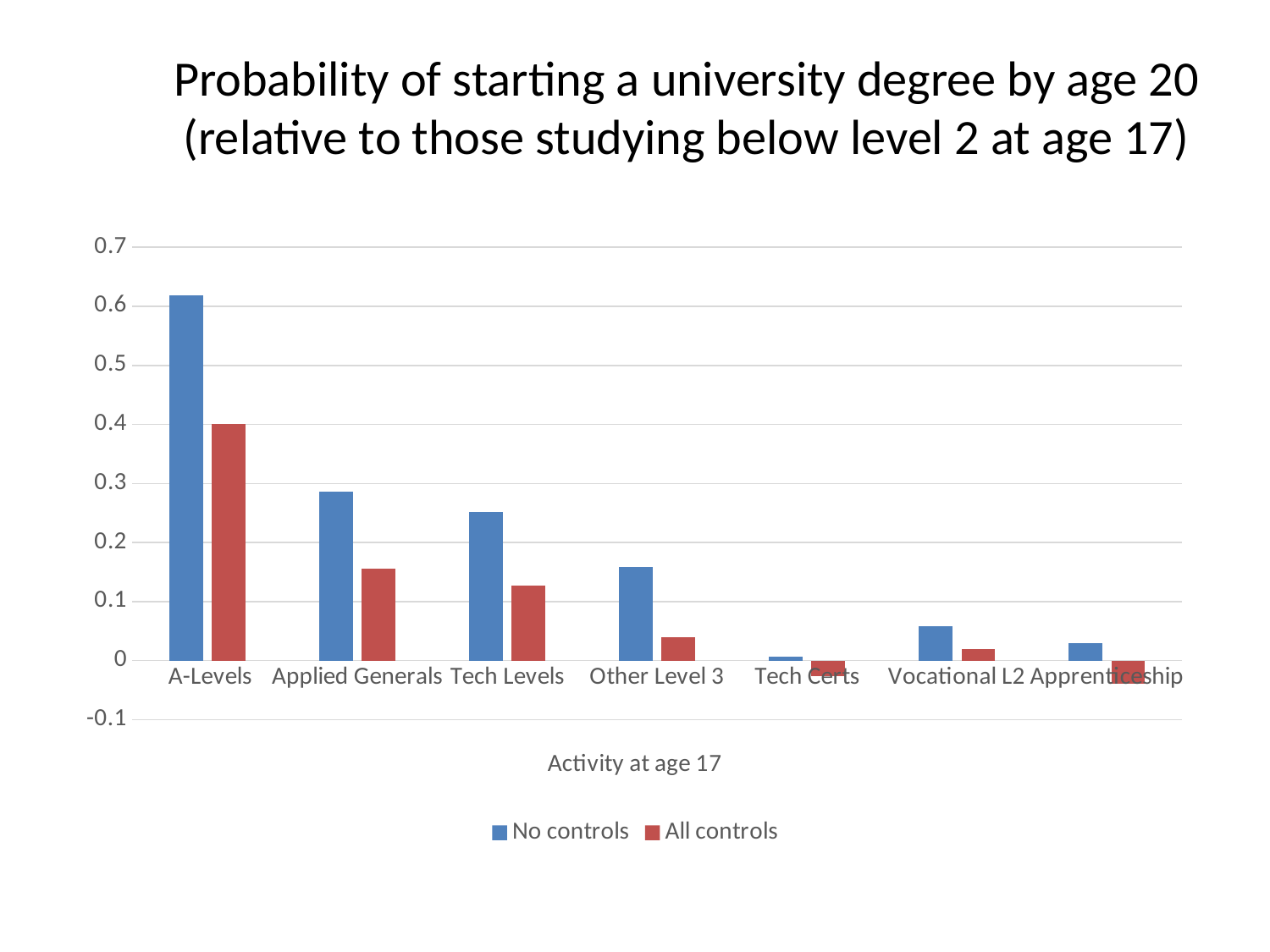
Which category has the lowest value for the All controls series? Apprenticeship What kind of chart is shown on the slide? Bar chart Which is larger: the No controls value for Applied Generals or the No controls value for Tech Levels? Applied Generals Is the All controls value for A-Levels greater or less than 0.3? greater How many activity categories are shown on the x axis? 7 Is the All controls value for Other Level 3 greater or less than 0.1? less How many series does the legend list? 2 Which category has the highest value for the No controls series? A-Levels Do the No controls values rise or fall across the first four categories, from A-Levels to Other Level 3? fall Which category has the highest value for the All controls series? A-Levels Is the No controls value for A-Levels greater or less than 0.5? greater What is the title of the x axis? Activity at age 17